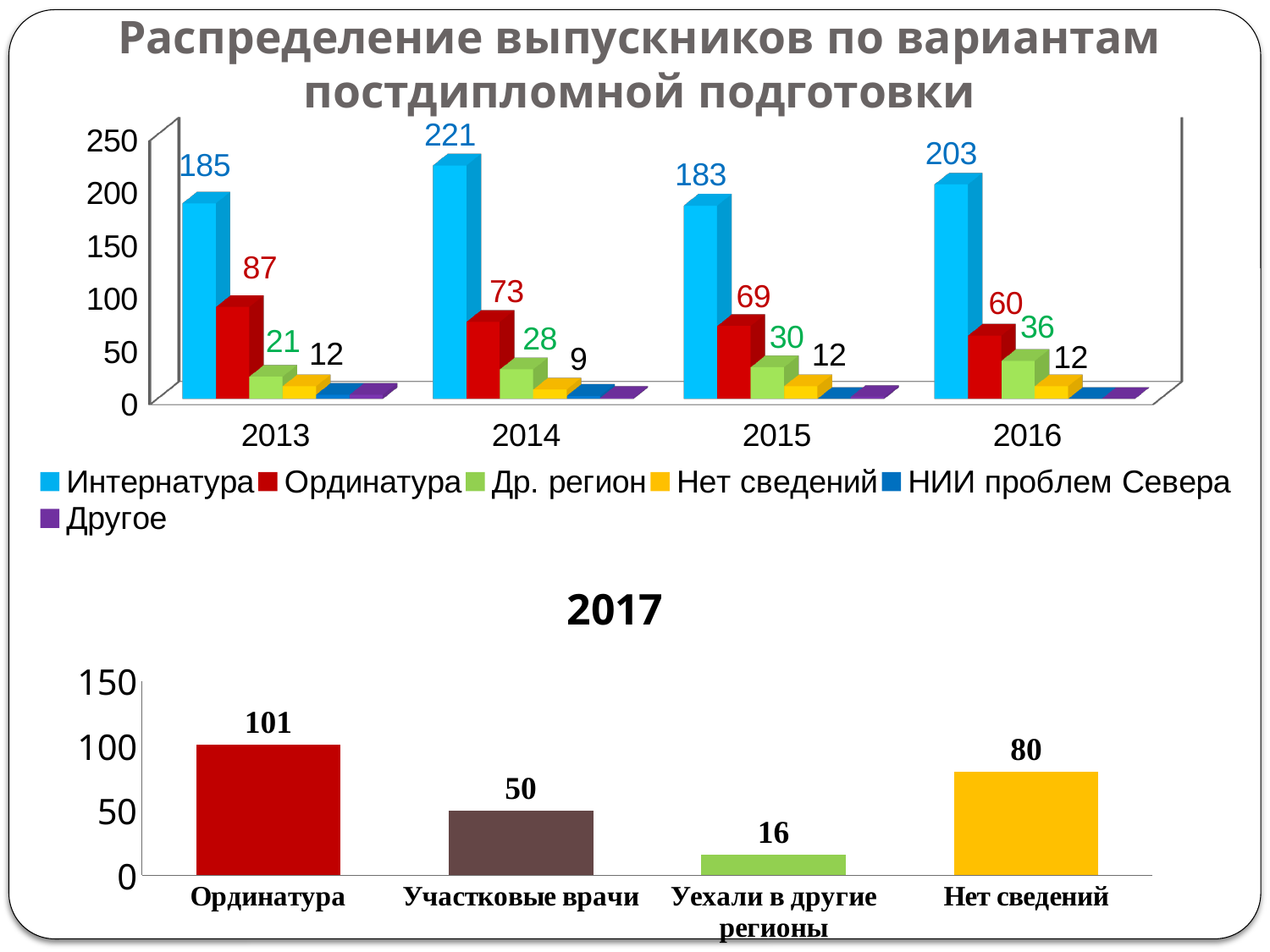
In the top chart, in which year is the Интернатура value highest? 2014 In the 2017 chart, which category has the highest value? Ординатура In the 2017 chart, what is the difference between Ординатура and Нет сведений? 21 In the 2017 chart, what is the value for Участковые врачи? 50 What kind of chart is the 2017 chart? bar chart In the top chart, what is the value for Ординатура in 2016? 60 In the top chart, does the Ординатура value rise or fall from 2013 to 2016? fall In the top chart, what is the difference between the Ординатура values in 2013 and 2016? 27 In the top chart, what is the value for Др. регион in 2015? 30 In the top chart, what is the value for Интернатура in 2014? 221 In the top chart, in which year is the Нет сведений value lowest? 2014 How many series does the legend of the top chart list? 6